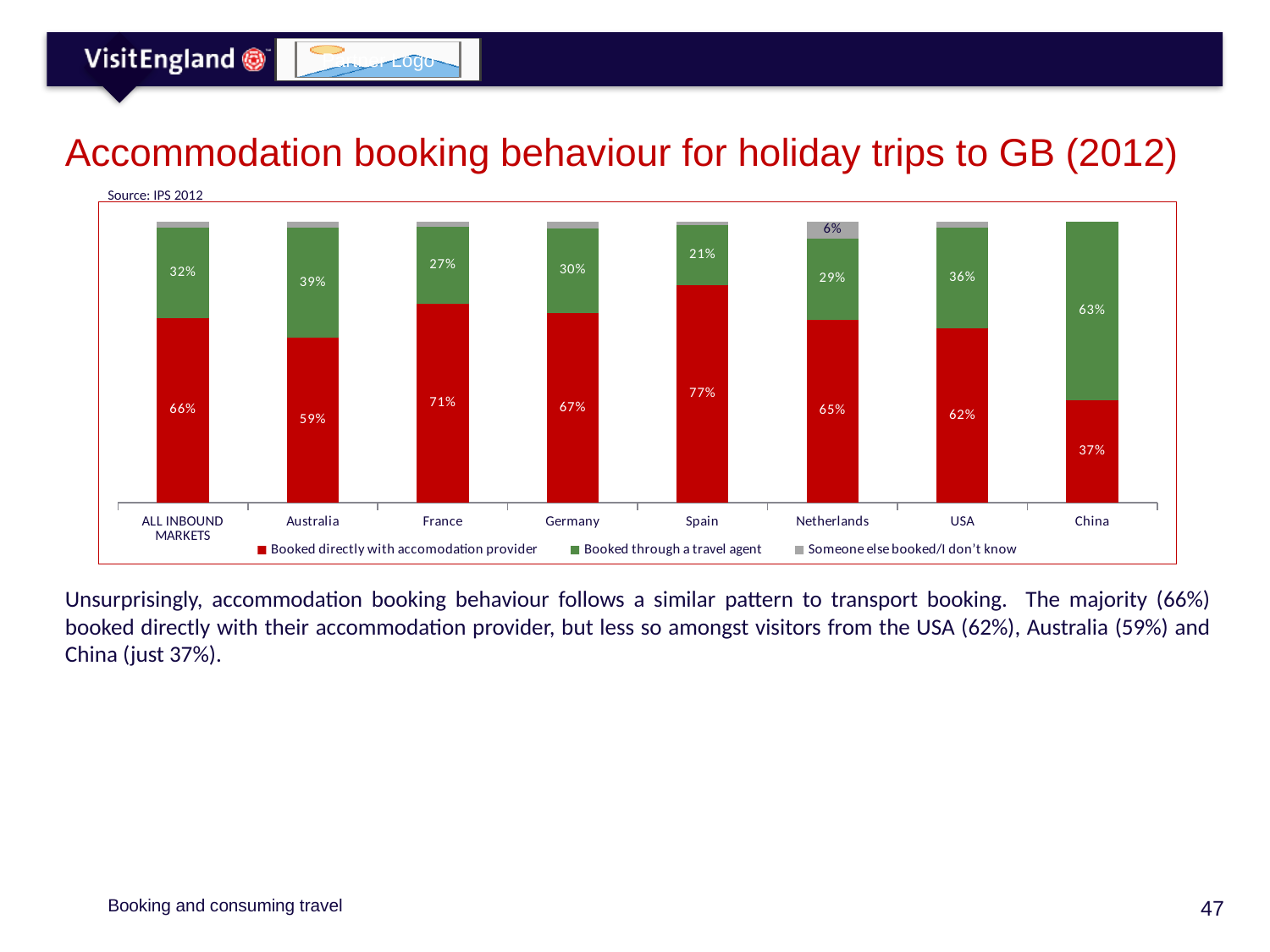
What type of chart is shown on the slide? Stacked bar chart What is the value for 'Booked directly with accomodation provider' for ALL INBOUND MARKETS? 66% What percentage of visitors from China booked through a travel agent? 63% How many markets are shown on the x axis of the chart? 8 How many series does the chart legend list? 3 What percentage of visitors from Spain booked directly with their accommodation provider? 77% Which market has the lowest share of visitors who booked directly with their accommodation provider? China Which is larger: the 'Booked through a travel agent' value for the USA or for Germany? USA Which colour represents 'Booked through a travel agent' in the chart? Green Which market has the highest share of visitors who booked directly with their accommodation provider? Spain What is the difference between the 'Booked directly with accomodation provider' values for France and Australia? 12% What percentage of visitors from the Netherlands fall under 'Someone else booked/I don't know'? 6%